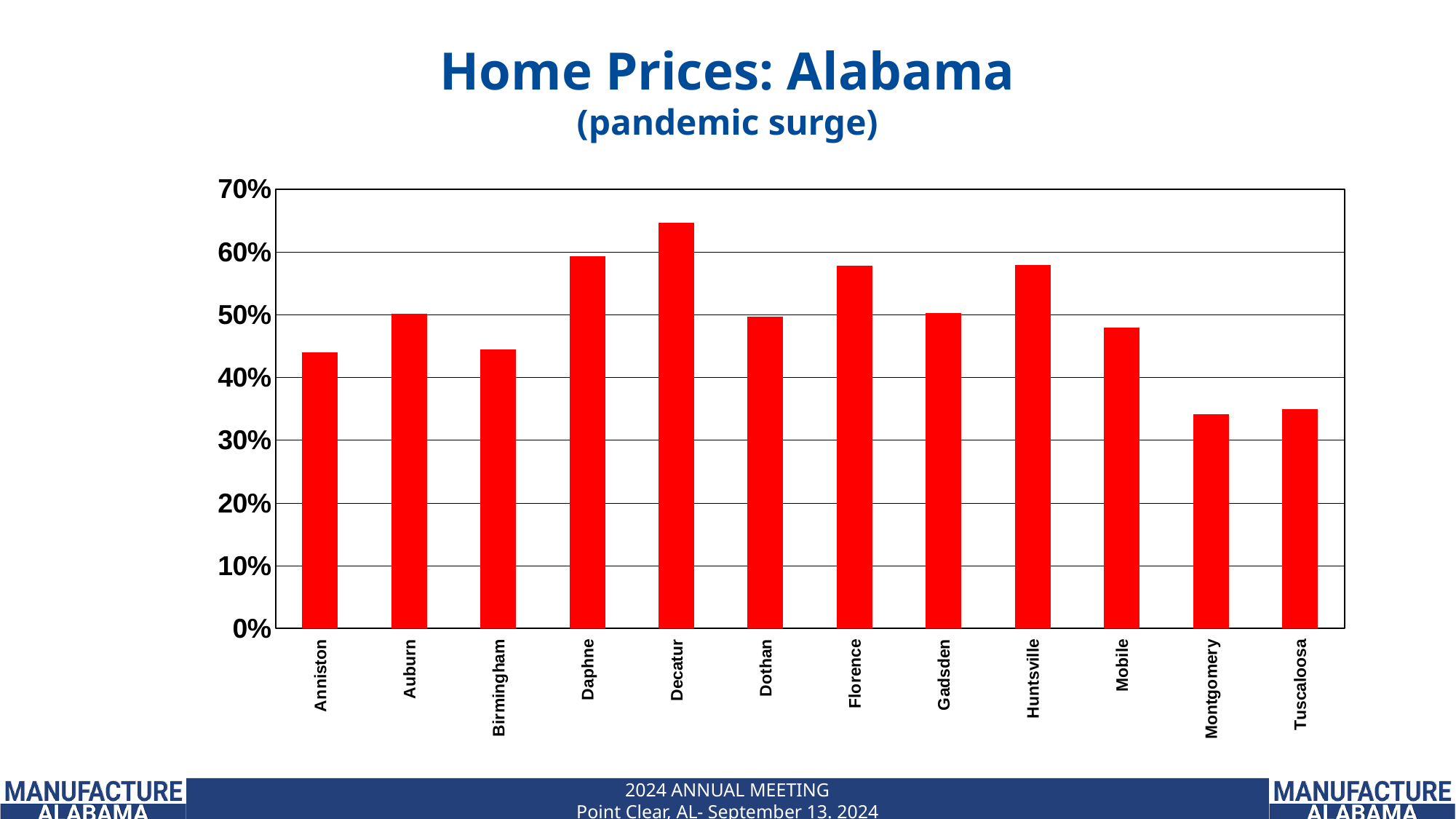
Is the value for Tuscaloosa greater or less than 40%? less What kind of chart is shown on the slide? bar chart Which is larger, the value for Daphne or the value for Anniston? Daphne Is the value for Mobile greater or less than 50%? less Is the value for Daphne greater or less than 50%? greater What is the title of the chart on the slide? Home Prices: Alabama (pandemic surge) How many cities are shown on the x axis of the chart? 12 Which is larger, the value for Montgomery or the value for Huntsville? Huntsville Which city has the highest value in the chart? Decatur